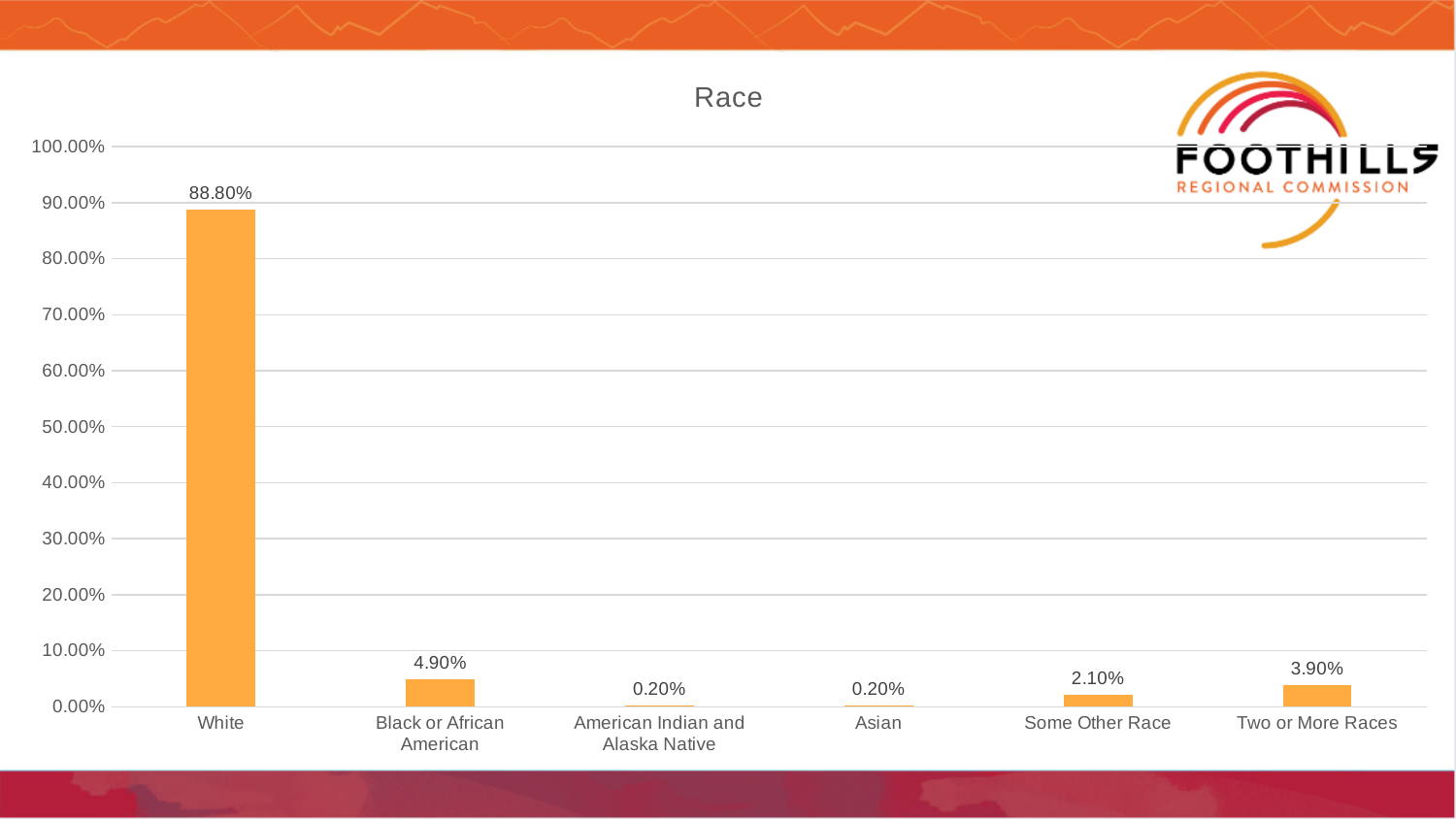
Which is larger, the value for Some Other Race or the value for Two or More Races? Two or More Races What is the title of the chart? Race What is the value for Two or More Races? 3.90% What is the value for Some Other Race? 2.10% What is the value for Black or African American? 4.90% How many categories are shown on the x axis? 6 Is the value for White greater or less than 80.00%? greater Which category has the highest value? White What is the value for White? 88.80% What is the difference between the values for White and Black or African American? 83.90% What is the difference between the values for Black or African American and Two or More Races? 1.00% What kind of chart is shown? Bar chart